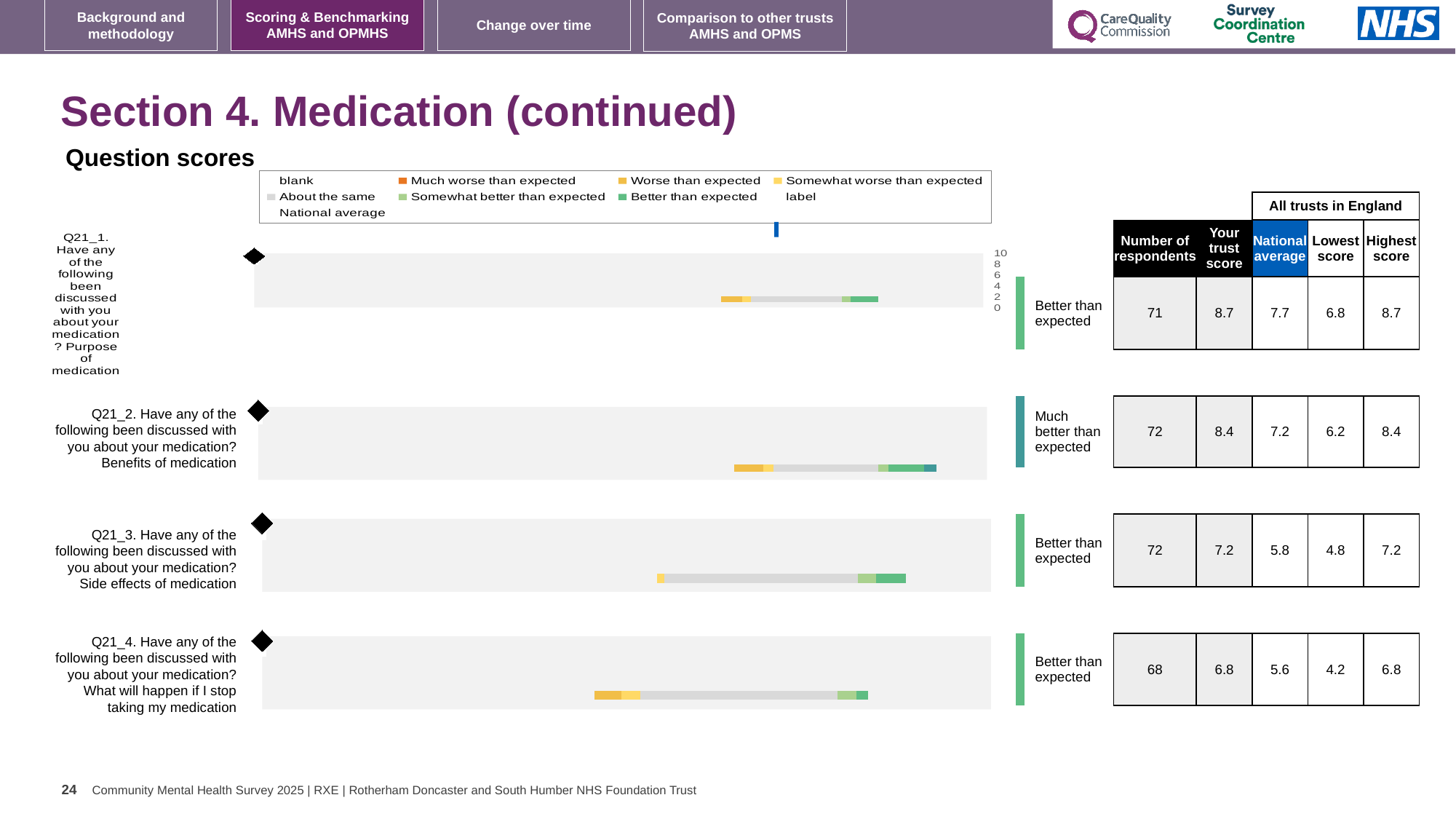
Which question has the highest 'Your trust score'? Q21_1 (Purpose of medication) How many entries does the legend above the charts list? 9 What kind of chart is used to show the question scores on this slide? bar chart What is the 'Your trust score' for Q21_2 (Benefits of medication)? 8.4 What is the highest score among all trusts in England for Q21_3 (Side effects of medication)? 7.2 Which has the larger trust score, Q21_1 or Q21_2? Q21_1 What is the difference between the trust score and the national average for Q21_3? 1.4 Which question has the lowest national average? Q21_4 (What will happen if I stop taking my medication) What benchmark category is shown next to the chart for Q21_2? Much better than expected How many respondents are shown for Q21_4 (What will happen if I stop taking my medication)? 68 How many questions (Q21_1 to Q21_4) are plotted on the slide? 4 What is the lowest score among all trusts in England for Q21_2? 6.2